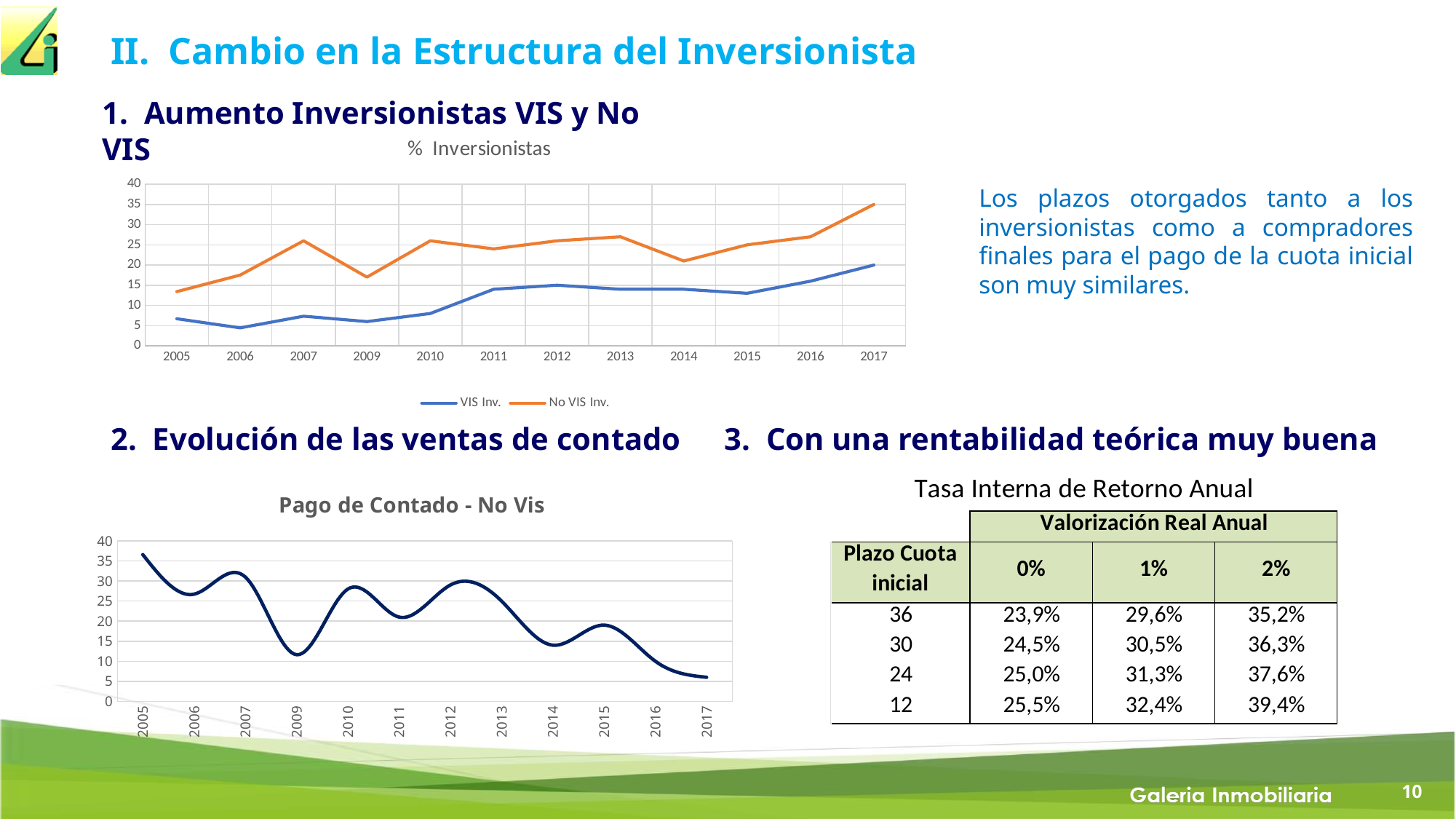
In the 'Pago de Contado - No Vis' chart, does the value overall rise or fall from 2005 to 2017? fall In the '% Inversionistas' chart, is the value for VIS Inv. in 2006 greater or less than 5? less How many years are shown on the x axis of the '% Inversionistas' chart? 12 In the 'Pago de Contado - No Vis' chart, is the value for 2017 greater or less than 10? less What kind of chart is the '% Inversionistas' chart? line chart In the '% Inversionistas' chart, does the VIS Inv. series overall rise or fall from 2005 to 2017? rise In the '% Inversionistas' chart, which series has the larger value in 2005, VIS Inv. or No VIS Inv.? No VIS Inv. In the '% Inversionistas' chart, is the value for No VIS Inv. in 2017 greater or less than 30? greater In the '% Inversionistas' chart, in which year is the VIS Inv. series lowest? 2006 How many series does the legend of the '% Inversionistas' chart list? 2 In the '% Inversionistas' chart, in which year is the No VIS Inv. series highest? 2017 In the 'Pago de Contado - No Vis' chart, in which year is the value highest? 2005